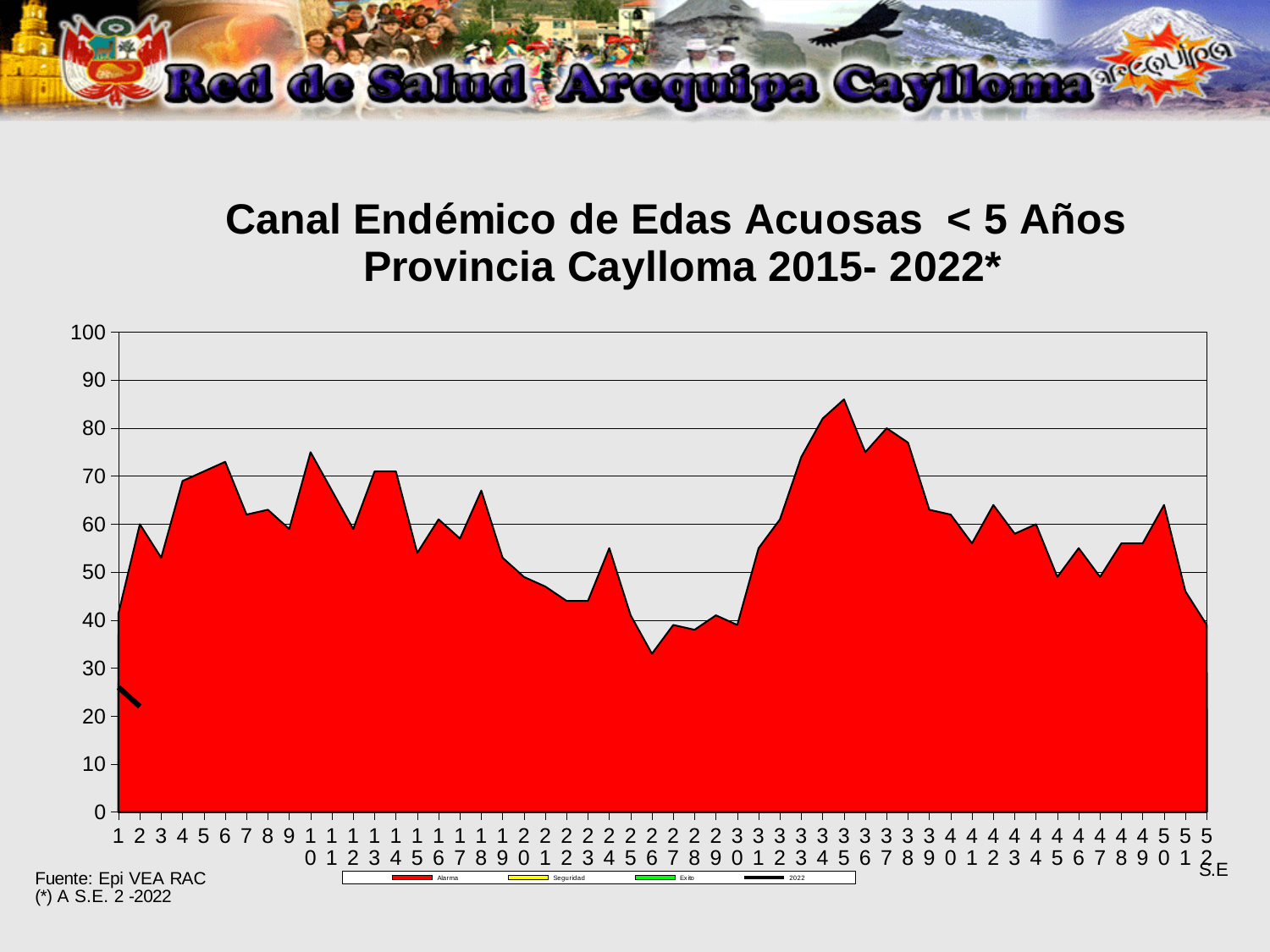
Is the 2022 line value at week 1 greater or less than 30? less At which week does the red Alarma area reach its highest value? 35 Which week has the larger Alarma value, week 35 or week 26? week 35 Is the Alarma value at week 1 greater or less than 50? less At which week does the red Alarma area reach its lowest value? 26 How many entries does the legend list? 4 Is the Alarma value at week 26 greater or less than 40? less What kind of chart is shown on the slide? area chart How many epidemiological weeks (S.E.) are shown along the x axis? 52 What colour is used for the Alarma series in the legend? red Between week 30 and week 35, do the Alarma values rise or fall? rise